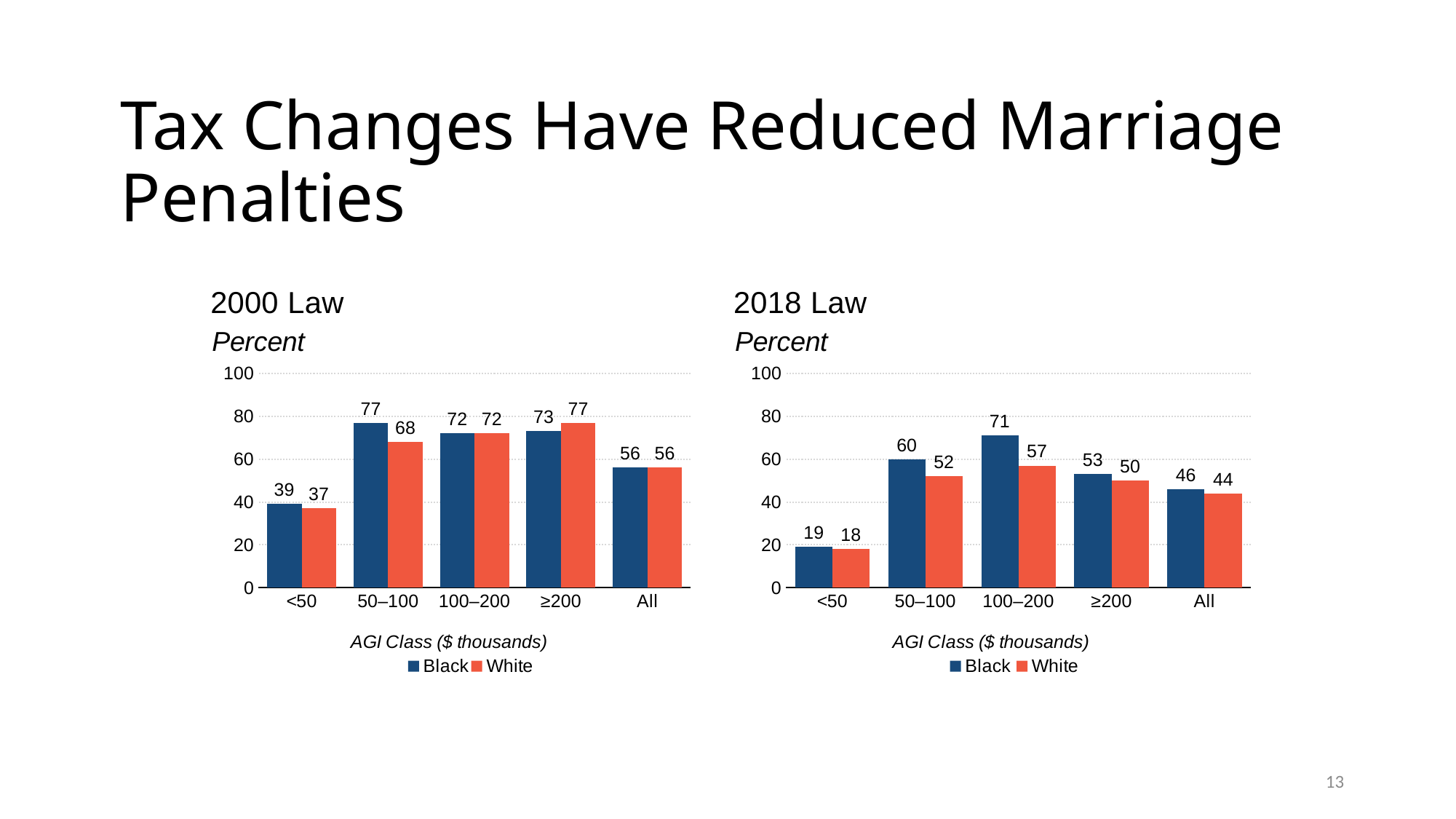
In the 2000 Law chart, what is the value for White in the All category? 56 In the 2000 Law chart, which AGI class has the lowest value for White? <50 In the 2000 Law chart, which is larger for the ≥200 AGI class, the Black value or the White value? White In the 2018 Law chart, which AGI class has the highest value for Black? 100–200 How many series does the legend of the 2018 Law chart list? 2 What are the two series listed in the legend of the 2000 Law chart? Black and White How many AGI classes are shown on the x axis of the 2000 Law chart? 5 What kind of chart is the 2000 Law chart? Bar chart In the 2000 Law chart, what is the value for Black in the 50–100 AGI class? 77 In the 2018 Law chart, what is the value for White in the 100–200 AGI class? 57 In the 2018 Law chart, what is the difference between the Black and White values for the 50–100 AGI class? 8 In the 2018 Law chart, is the value for Black in the <50 AGI class greater or less than 20? less